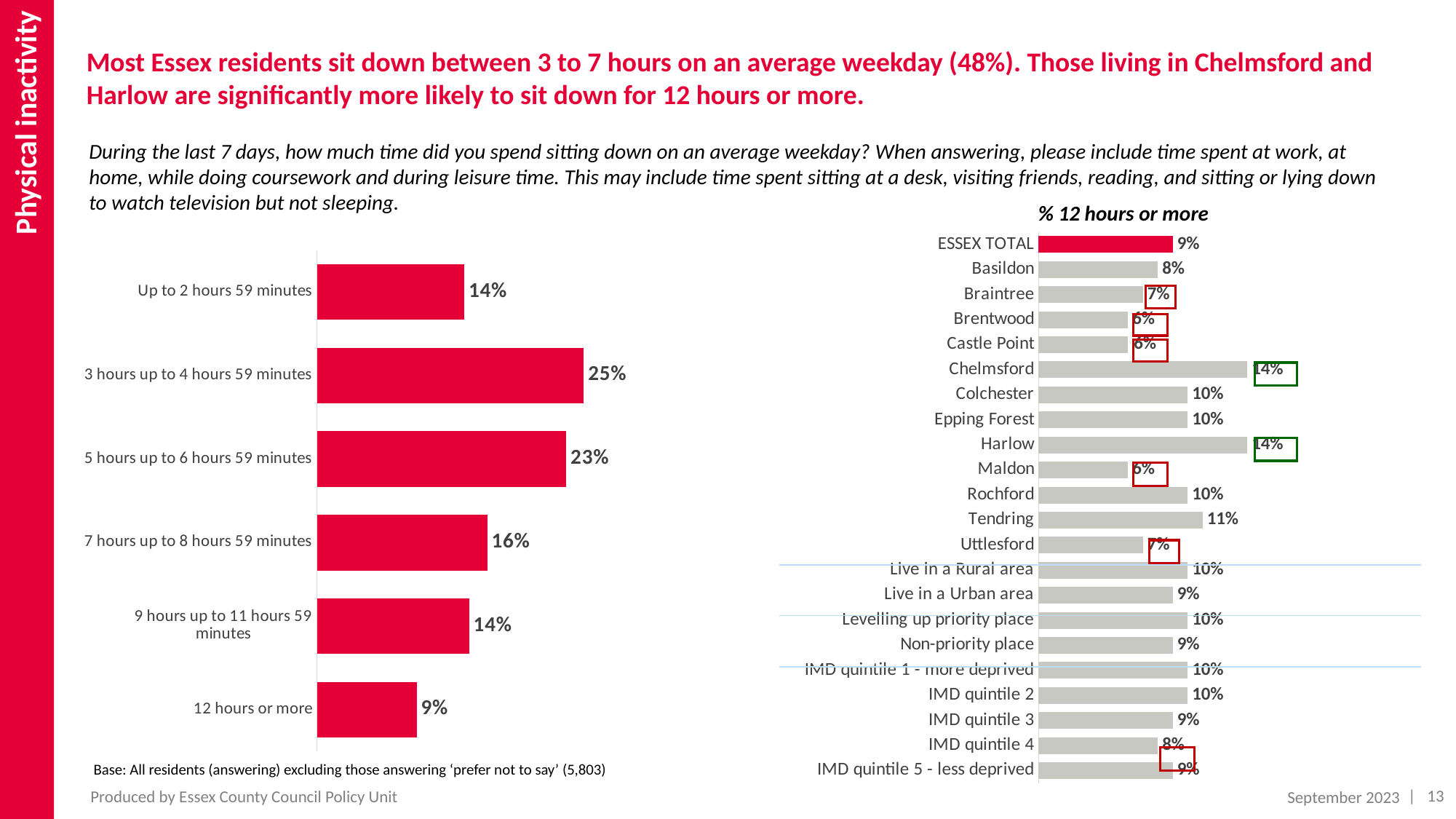
What is the title of the chart on the right of the slide? % 12 hours or more In the '% 12 hours or more' chart, what is the value for ESSEX TOTAL? 9% In the left chart, which sitting-time category has the highest percentage? 3 hours up to 4 hours 59 minutes In the left chart, what is the difference in percentage points between '5 hours up to 6 hours 59 minutes' and '7 hours up to 8 hours 59 minutes'? 7 percentage points In the '% 12 hours or more' chart, what is the value for Tendring? 11% How many sitting-time categories are shown in the left chart? 6 In the left chart, which sitting-time category has the lowest percentage? 12 hours or more In the '% 12 hours or more' chart, what is the difference between Harlow and Maldon? 8 percentage points In the left chart, what percentage of Essex residents sit down for 3 hours up to 4 hours 59 minutes on an average weekday? 25% In the '% 12 hours or more' chart, which is larger, the value for Chelmsford or the value for Basildon? Chelmsford In the '% 12 hours or more' chart, what is the value for IMD quintile 4? 8% What type of chart is the left chart? Bar chart